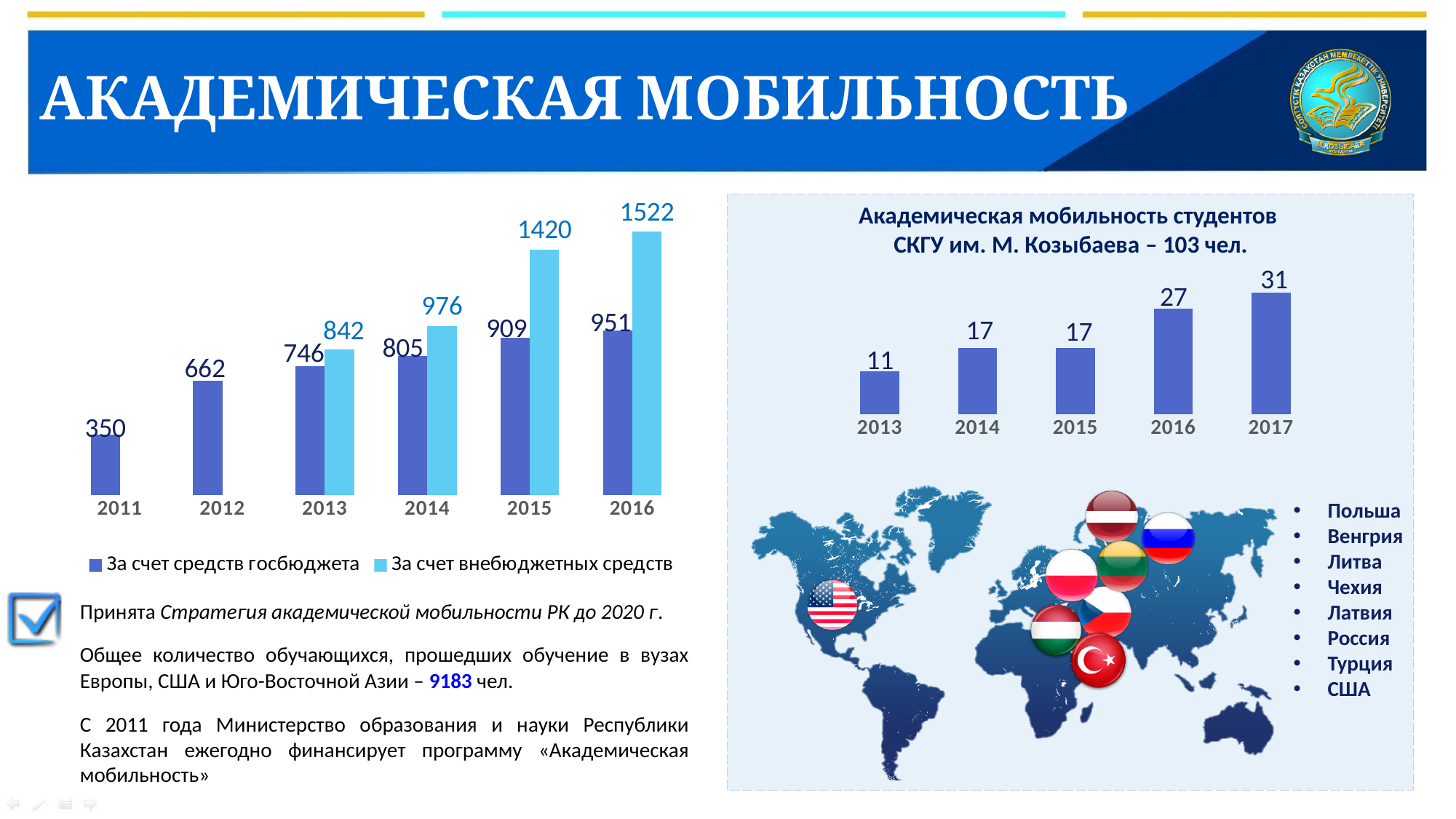
In the left chart, does the value for 'За счет средств госбюджета' rise or fall from 2011 to 2016? rise What kind of chart is the chart titled 'Академическая мобильность студентов СКГУ им. М. Козыбаева – 103 чел.'? bar chart In the chart titled 'Академическая мобильность студентов СКГУ им. М. Козыбаева – 103 чел.', which year has the lowest value? 2013 In the left chart, which year has the highest value for 'За счет внебюджетных средств'? 2016 In the left chart, what is the value for 'За счет средств госбюджета' in 2011? 350 In the chart titled 'Академическая мобильность студентов СКГУ им. М. Козыбаева – 103 чел.', what is the difference between 2017 and 2013? 20 In the left chart, what is the difference between the two series in 2016? 571 In the left chart, what is the value for 'За счет внебюджетных средств' in 2015? 1420 In the left chart, which is larger in 2014: 'За счет средств госбюджета' or 'За счет внебюджетных средств'? За счет внебюджетных средств In the chart titled 'Академическая мобильность студентов СКГУ им. М. Козыбаева – 103 чел.', what is the value for 2016? 27 How many series does the legend of the left chart list? 2 How many years are shown on the x axis of the chart titled 'Академическая мобильность студентов СКГУ им. М. Козыбаева – 103 чел.'? 5